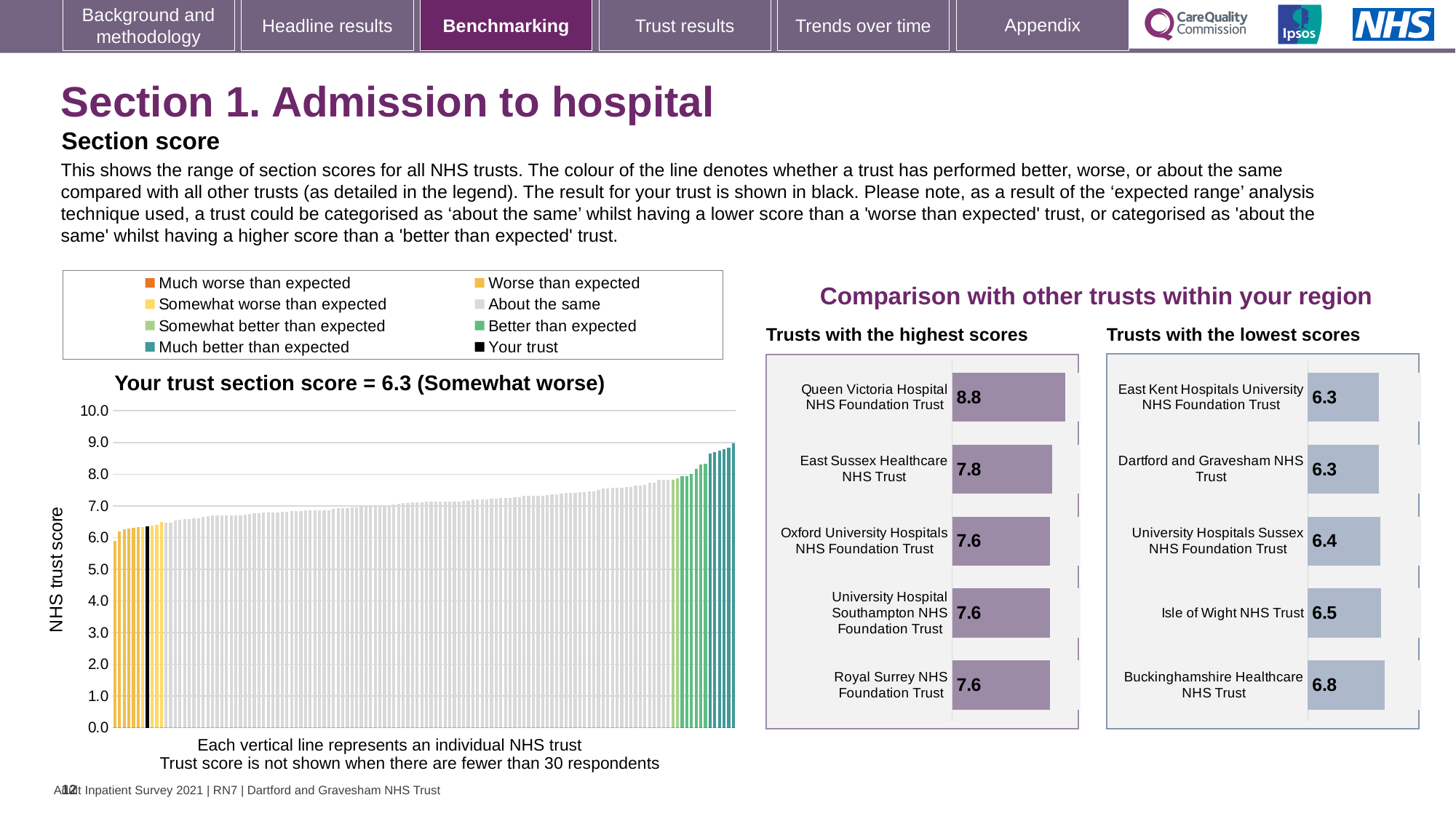
In the 'Trusts with the lowest scores' chart, what is the score for Buckinghamshire Healthcare NHS Trust? 6.8 What kind of chart is the 'Your trust section score' chart on the left of the slide? bar chart In the 'Trusts with the lowest scores' chart, which is larger: the score for Isle of Wight NHS Trust or the score for Dartford and Gravesham NHS Trust? Isle of Wight NHS Trust In the 'Trusts with the lowest scores' chart, which trust has the highest score? Buckinghamshire Healthcare NHS Trust In the 'Your trust section score' chart, what is the highest value shown on the y axis? 10.0 In the 'Your trust section score' chart, what is the section score for your trust? 6.3 How many entries does the legend above the 'Your trust section score' chart list? 8 In the 'Trusts with the highest scores' chart, what is the difference between the scores of Queen Victoria Hospital NHS Foundation Trust and East Sussex Healthcare NHS Trust? 1.0 How many trusts are shown in the 'Trusts with the highest scores' chart? 5 In the 'Trusts with the highest scores' chart, what is the score for Queen Victoria Hospital NHS Foundation Trust? 8.8 In the 'Trusts with the highest scores' chart, which trust has the highest score? Queen Victoria Hospital NHS Foundation Trust In the 'Your trust section score' chart, do the bars rise or fall from left to right? rise